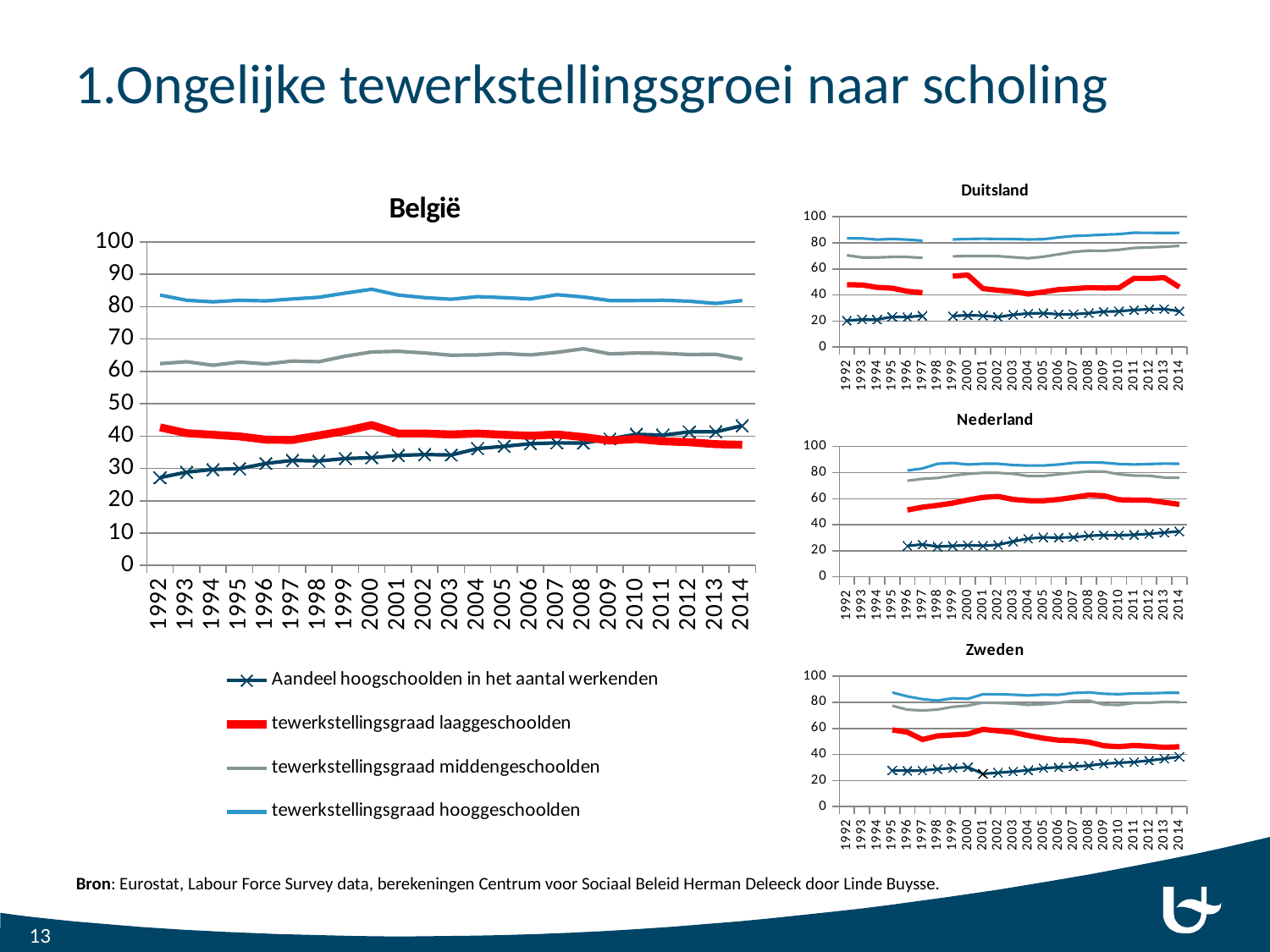
In the 'België' chart, which series has the highest values across all years? tewerkstellingsgraad hooggeschoolden How many years are shown on the x axis of the 'België' chart? 23 In the 'België' chart, is the value for 'Aandeel hoogschoolden in het aantal werkenden' in 1992 greater or less than 30? less In the 'België' chart, is the value for 'tewerkstellingsgraad laaggeschoolden' in 2014 greater or less than 40? less In the 'België' chart, is the value for 'tewerkstellingsgraad hooggeschoolden' in 2000 greater or less than 80? greater What are the titles of the three small charts on the right side of the slide? Duitsland, Nederland, Zweden In the 'Zweden' chart, does the red 'tewerkstellingsgraad laaggeschoolden' line rise or fall from 1995 to 2014? fall In the 'België' chart, does 'Aandeel hoogschoolden in het aantal werkenden' rise or fall from 1992 to 2014? rise In the 'België' chart, which is larger in 2014: 'tewerkstellingsgraad hooggeschoolden' or 'tewerkstellingsgraad laaggeschoolden'? tewerkstellingsgraad hooggeschoolden What kind of chart is the 'België' chart? line chart How many series does the legend of the 'België' chart list? 4